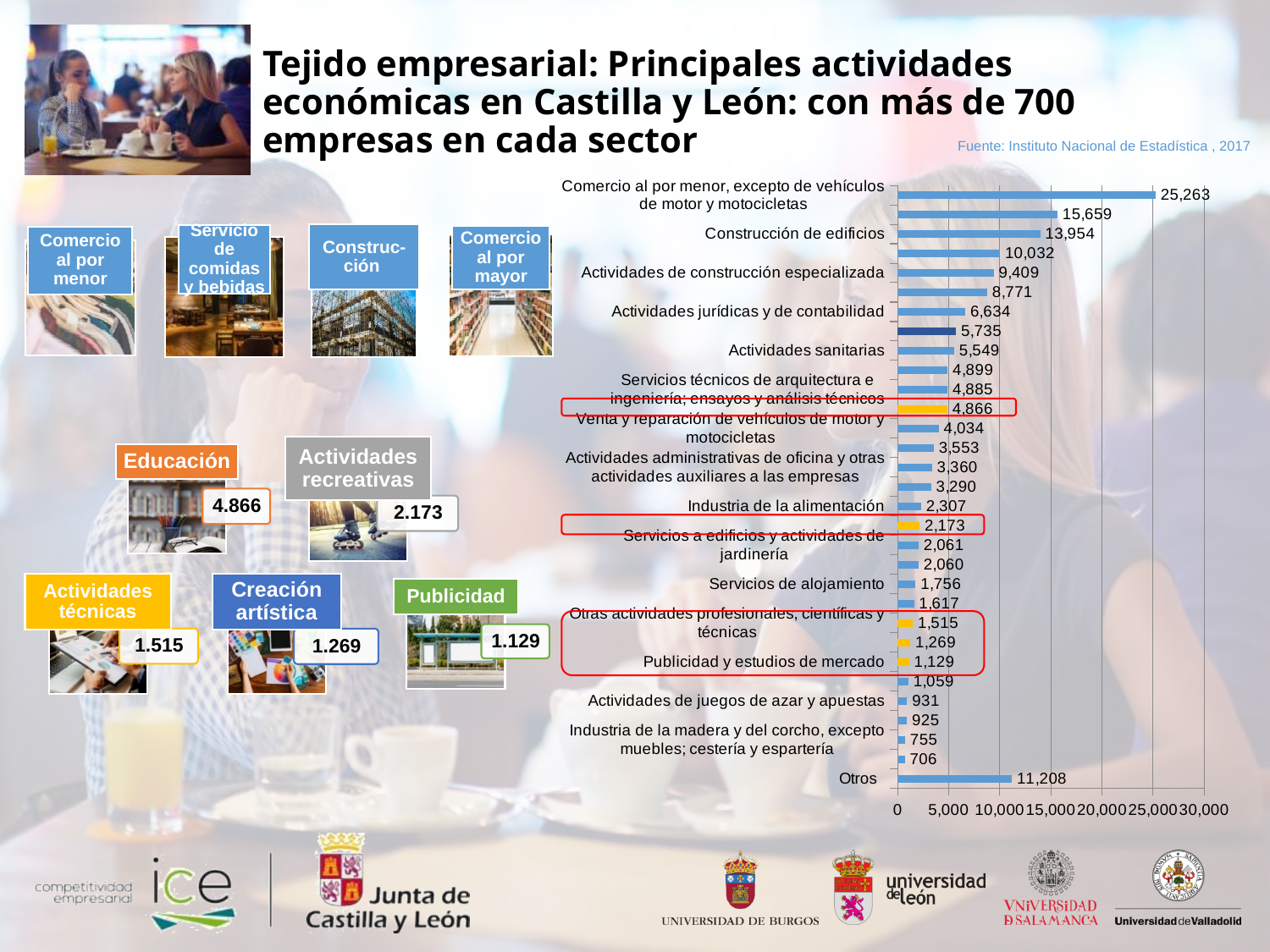
What is the value for 'Construcción de edificios'? 13,954 Is the value for 'Actividades jurídicas y de contabilidad' greater or less than 5,000? greater Which is larger, 'Construcción de edificios' or 'Otros'? Construcción de edificios What is the value for 'Actividades sanitarias'? 5,549 What source is cited for the chart data? Instituto Nacional de Estadística, 2017 What is the value for 'Otros'? 11,208 Which category has the highest value in the chart? Comercio al por menor, excepto de vehículos de motor y motocicletas What is the value for 'Comercio al por menor, excepto de vehículos de motor y motocicletas'? 25,263 What is the smallest value labeled on the chart? 706 What is the difference between 'Comercio al por menor, excepto de vehículos de motor y motocicletas' and 'Construcción de edificios'? 11,309 What is the value for 'Publicidad y estudios de mercado'? 1,129 What type of chart is shown on the slide? Bar chart